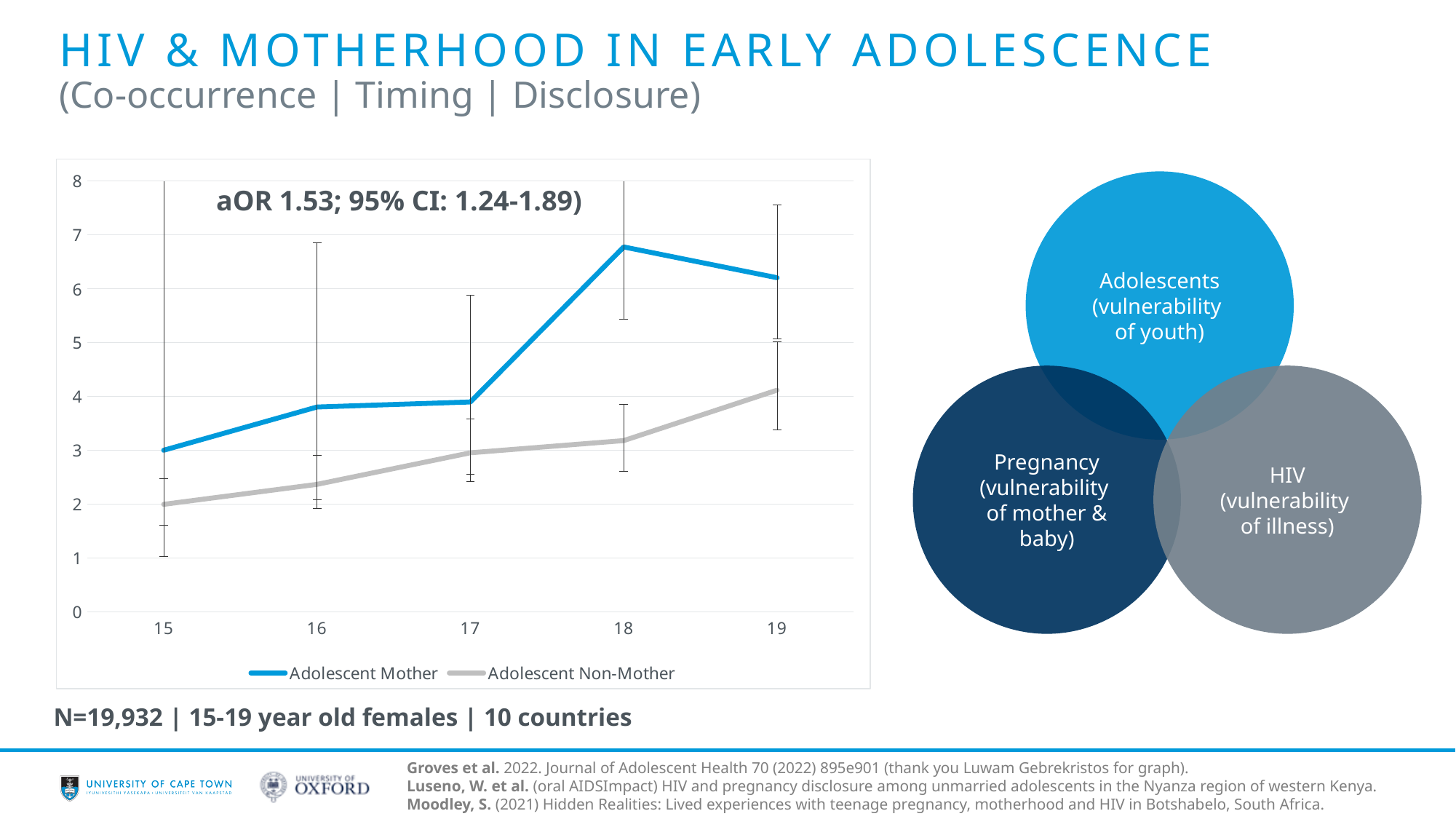
At which age is the Adolescent Mother line highest? 18 What kind of chart is shown on the slide? line chart Is the value for Adolescent Mother at age 18 greater or less than 6? greater At which age is the Adolescent Non-Mother line lowest? 15 What is the value for Adolescent Mother at age 15? 3 Is the value for Adolescent Mother at age 16 greater or less than 4? less At age 18, which series has the larger value, Adolescent Mother or Adolescent Non-Mother? Adolescent Mother What is the value for Adolescent Non-Mother at age 15? 2 How many age points are plotted along the x axis of the chart? 5 Does the Adolescent Non-Mother line rise or fall from age 15 to age 19? rise Is the value for Adolescent Non-Mother at age 19 greater or less than 5? less How many series does the chart legend list? 2